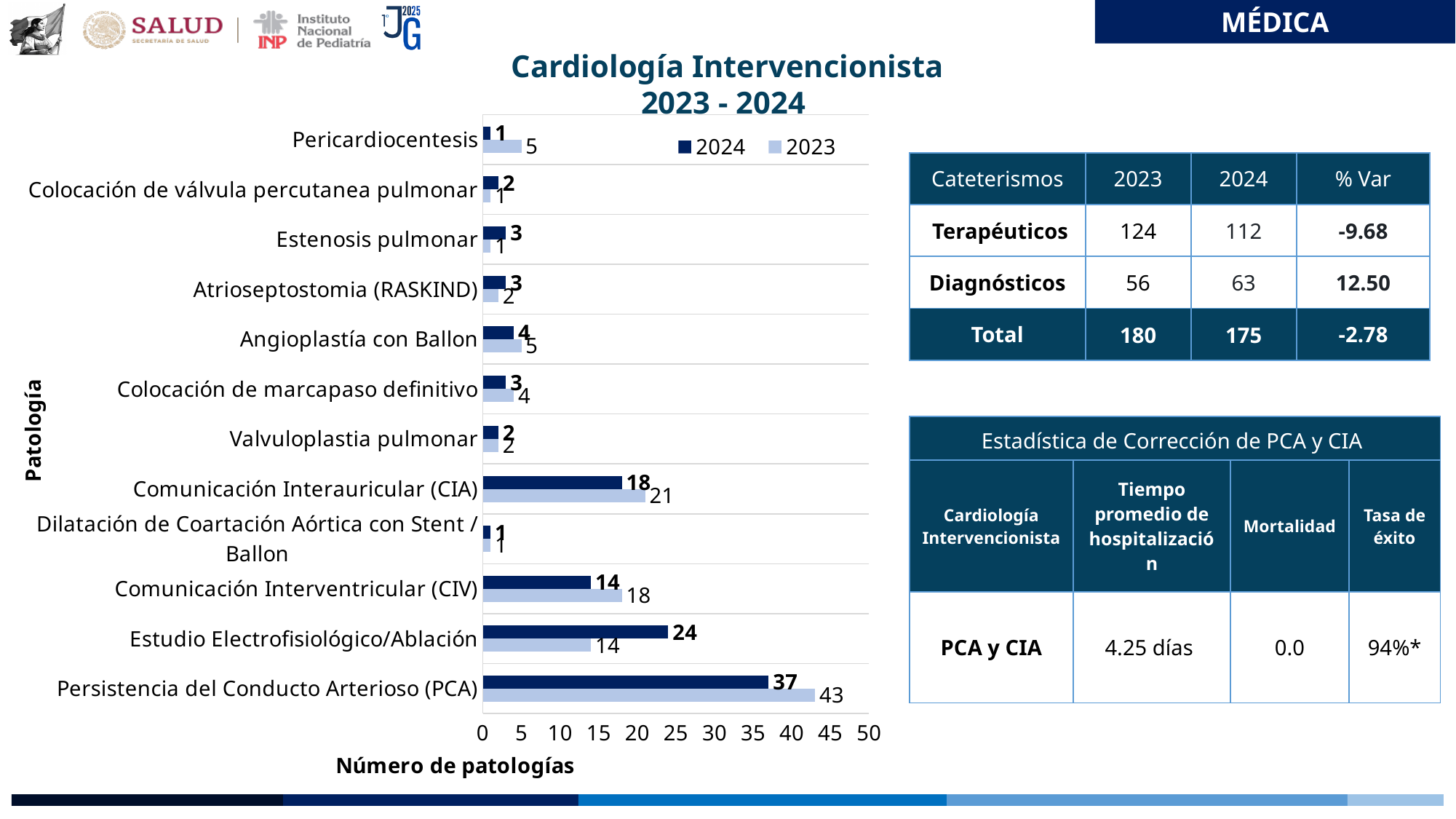
What is the 2024 value for Estudio Electrofisiológico/Ablación? 24 What is the 2023 value for Comunicación Interauricular (CIA)? 21 What type of chart is shown on the slide? bar chart What is the difference between the 2023 and 2024 values for Comunicación Interventricular (CIV)? 4 For Estudio Electrofisiológico/Ablación, which year has the larger value, 2023 or 2024? 2024 Which pathology has the highest 2023 value? Persistencia del Conducto Arterioso (PCA) What is the label of the x axis of the chart? Número de patologías What is the difference between the 2023 and 2024 values for Persistencia del Conducto Arterioso (PCA)? 6 How many series does the chart legend list? 2 How many pathology categories are plotted in the chart? 12 Which pathology has the lowest 2024 value? Pericardiocentesis and Dilatación de Coartación Aórtica con Stent / Ballon (both 1) What is the 2024 value for Persistencia del Conducto Arterioso (PCA)? 37